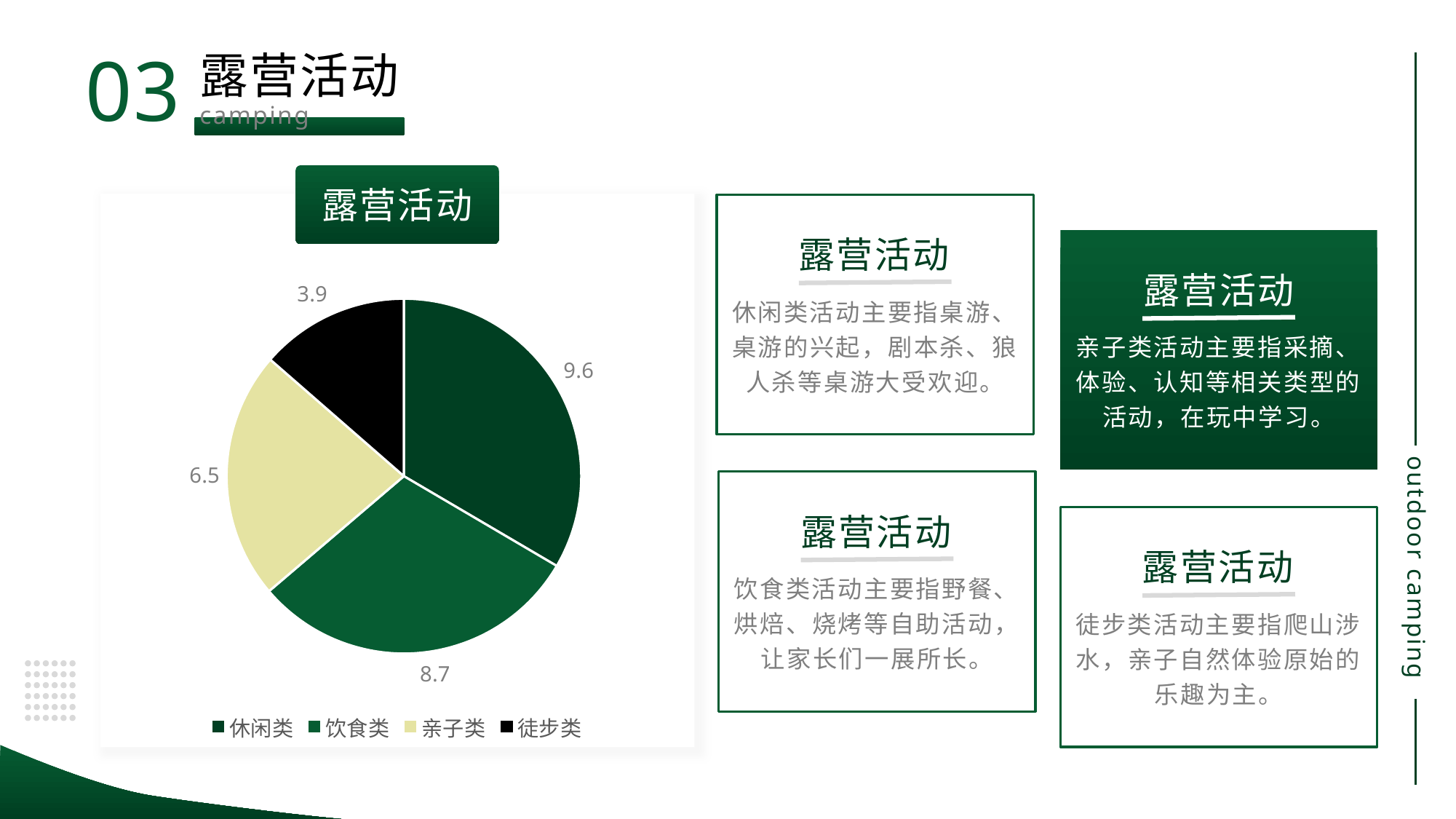
What is the value for 饮食类 in the pie chart? 8.7 What is the difference between the values for 休闲类 and 徒步类? 5.7 What type of chart is shown on the slide? Pie chart What is the value for 休闲类 in the pie chart? 9.6 What is the title of the pie chart? 露营活动 What is the value for 徒步类 in the pie chart? 3.9 Which category has the largest slice in the pie chart? 休闲类 What is the value for 亲子类 in the pie chart? 6.5 Which is larger, the value for 饮食类 or the value for 亲子类? 饮食类 Which category has the smallest slice in the pie chart? 徒步类 How many categories does the pie chart have? 4 What is the total of all the values shown in the pie chart? 28.7